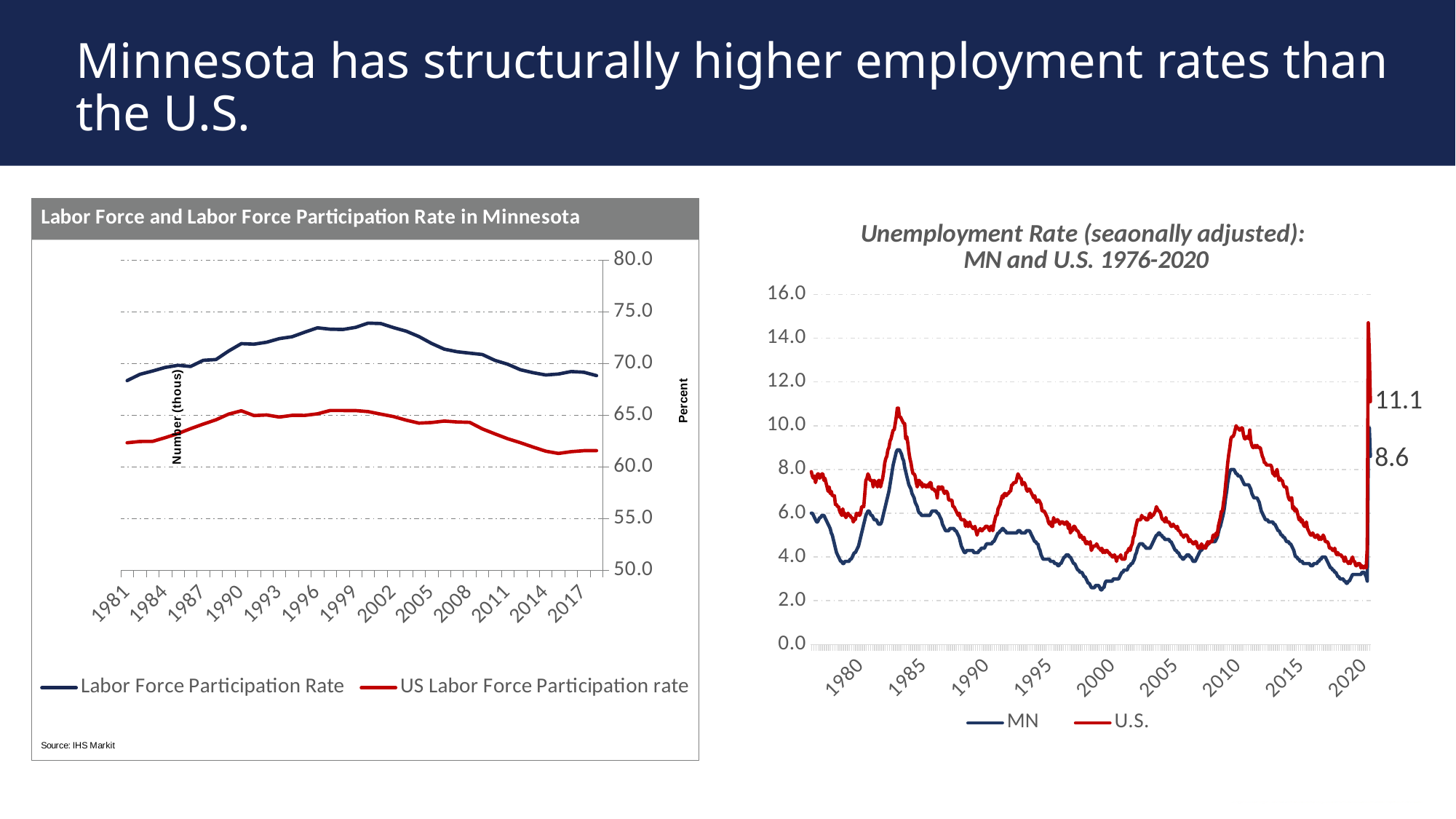
In the 'Labor Force and Labor Force Participation Rate in Minnesota' chart, is the Labor Force Participation Rate in 2017 greater or less than 65.0? greater In the 'Unemployment Rate (seasonally adjusted)' chart, what is the difference between the labelled final U.S. value and the labelled final MN value? 2.5 What type of chart is the 'Unemployment Rate (seasonally adjusted): MN and U.S. 1976-2020' chart? Line chart In the 'Unemployment Rate (seasonally adjusted)' chart, is the U.S. unemployment rate at its early-1980s peak greater or less than 10.0? greater How many series does the legend of the 'Unemployment Rate (seasonally adjusted)' chart list? 2 What type of chart is the 'Labor Force and Labor Force Participation Rate in Minnesota' chart? Line chart In the 'Unemployment Rate (seasonally adjusted)' chart, what is the labelled final value for the MN series? 8.6 In the 'Unemployment Rate (seasonally adjusted)' chart, what is the labelled final value for the U.S. series? 11.1 In the 'Unemployment Rate (seasonally adjusted)' chart, which series has the higher labelled final value, MN or U.S.? U.S. In the 'Unemployment Rate (seasonally adjusted)' chart, is the MN unemployment rate around 2000 greater or less than 4.0? less In the 'Labor Force and Labor Force Participation Rate in Minnesota' chart, which series is higher in 1999, Labor Force Participation Rate or US Labor Force Participation rate? Labor Force Participation Rate In the 'Labor Force and Labor Force Participation Rate in Minnesota' chart, does the Labor Force Participation Rate rise or fall from 2002 to 2017? Fall